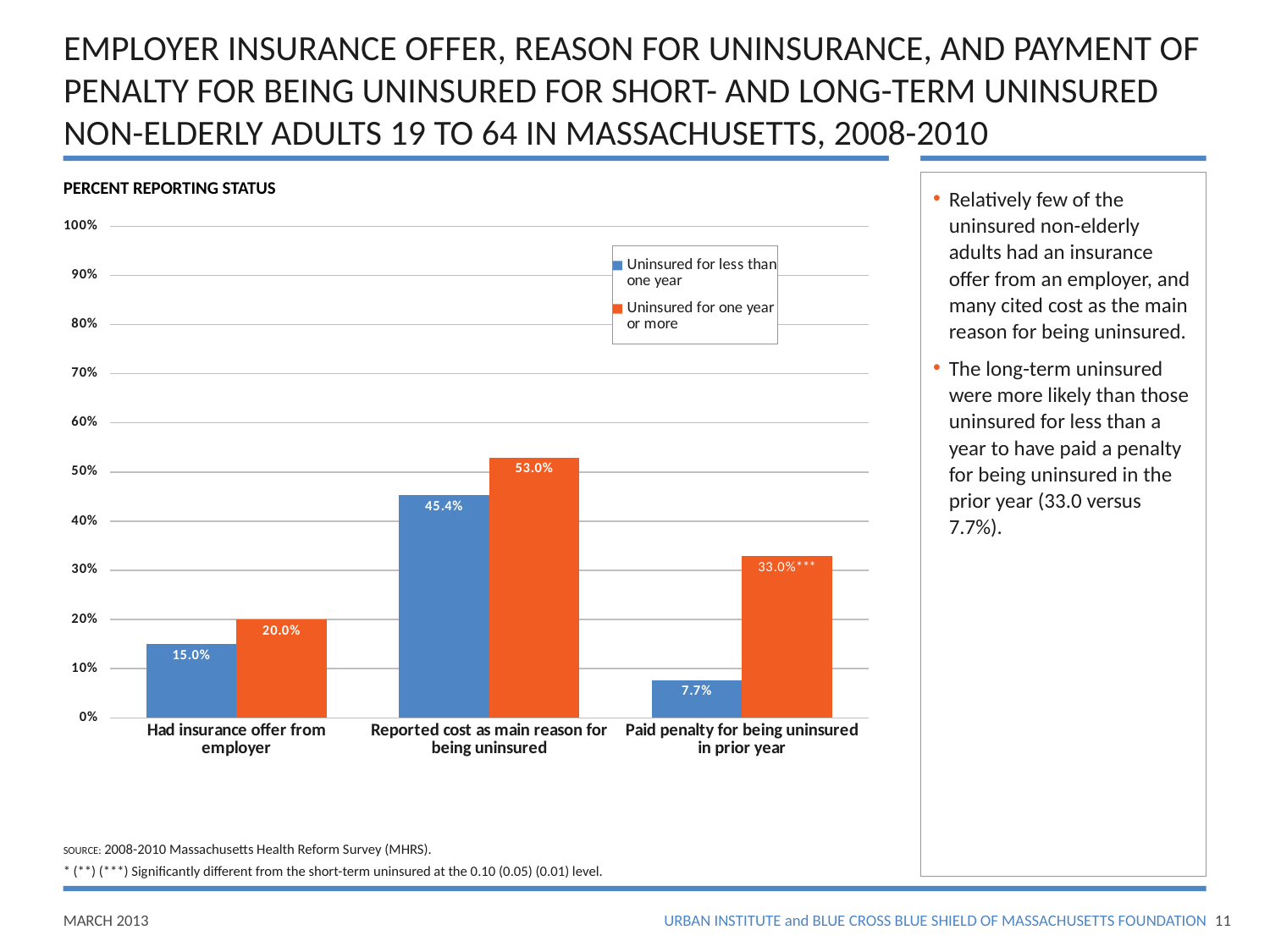
Is the value for 'Uninsured for less than one year' in 'Reported cost as main reason for being uninsured' greater or less than 40%? greater Which category has the highest value for the 'Uninsured for one year or more' series? Reported cost as main reason for being uninsured What type of chart is shown on the slide? Bar chart Which category has the lowest value for the 'Uninsured for less than one year' series? Paid penalty for being uninsured in prior year How many series does the chart legend list? 2 What percentage of those uninsured for less than one year paid a penalty for being uninsured in the prior year? 7.7% What percentage of those uninsured for one year or more had an insurance offer from an employer? 20.0% What percentage of those uninsured for less than one year had an insurance offer from an employer? 15.0% How many categories are shown on the x axis of the chart? 3 For 'Reported cost as main reason for being uninsured', which group has the larger value: uninsured for less than one year or uninsured for one year or more? Uninsured for one year or more What percentage of those uninsured for one year or more reported cost as the main reason for being uninsured? 53.0% What is the difference between the long-term and short-term uninsured values for 'Paid penalty for being uninsured in prior year'? 25.3%